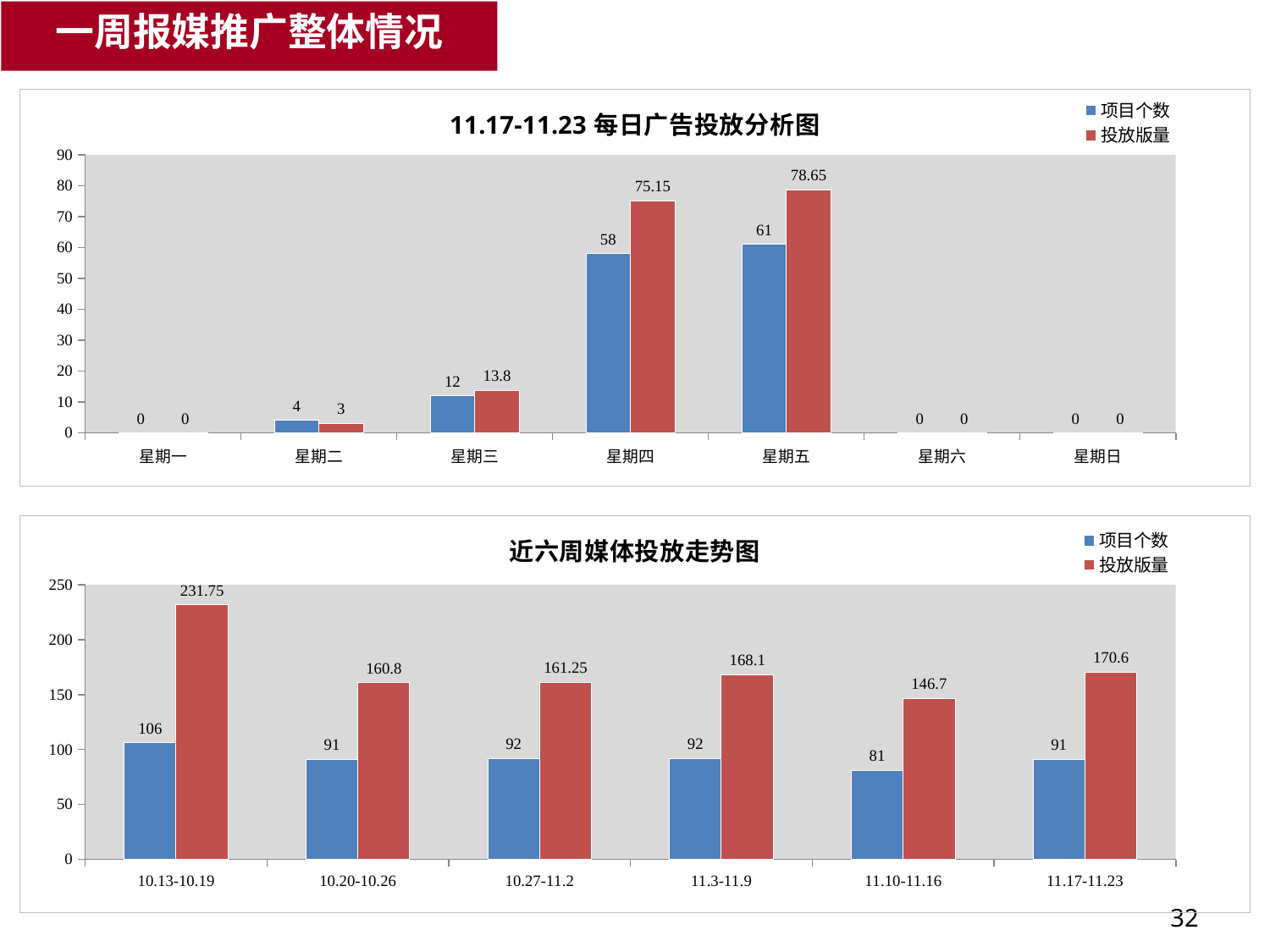
In the top chart (11.17-11.23 每日广告投放分析图), how many series does the legend list? 2 In the bottom chart (近六周媒体投放走势图), what is the 投放版量 value for 10.13-10.19? 231.75 In the top chart (11.17-11.23 每日广告投放分析图), what is the difference between the 投放版量 values for 星期五 and 星期四? 3.5 In the top chart (11.17-11.23 每日广告投放分析图), which day has the highest 投放版量? 星期五 In the top chart (11.17-11.23 每日广告投放分析图), what is the 项目个数 value for 星期五? 61 What kind of chart is the bottom chart (近六周媒体投放走势图)? Bar chart In the bottom chart (近六周媒体投放走势图), which is larger: the 投放版量 for 11.17-11.23 or for 11.3-11.9? 11.17-11.23 In the top chart (11.17-11.23 每日广告投放分析图), how many days are shown on the x axis? 7 In the bottom chart (近六周媒体投放走势图), what is the difference between the 项目个数 values for 10.13-10.19 and 11.10-11.16? 25 In the bottom chart (近六周媒体投放走势图), which week has the lowest 投放版量? 11.10-11.16 In the top chart (11.17-11.23 每日广告投放分析图), what is the 投放版量 value for 星期四? 75.15 In the bottom chart (近六周媒体投放走势图), what is the 项目个数 value for 11.10-11.16? 81